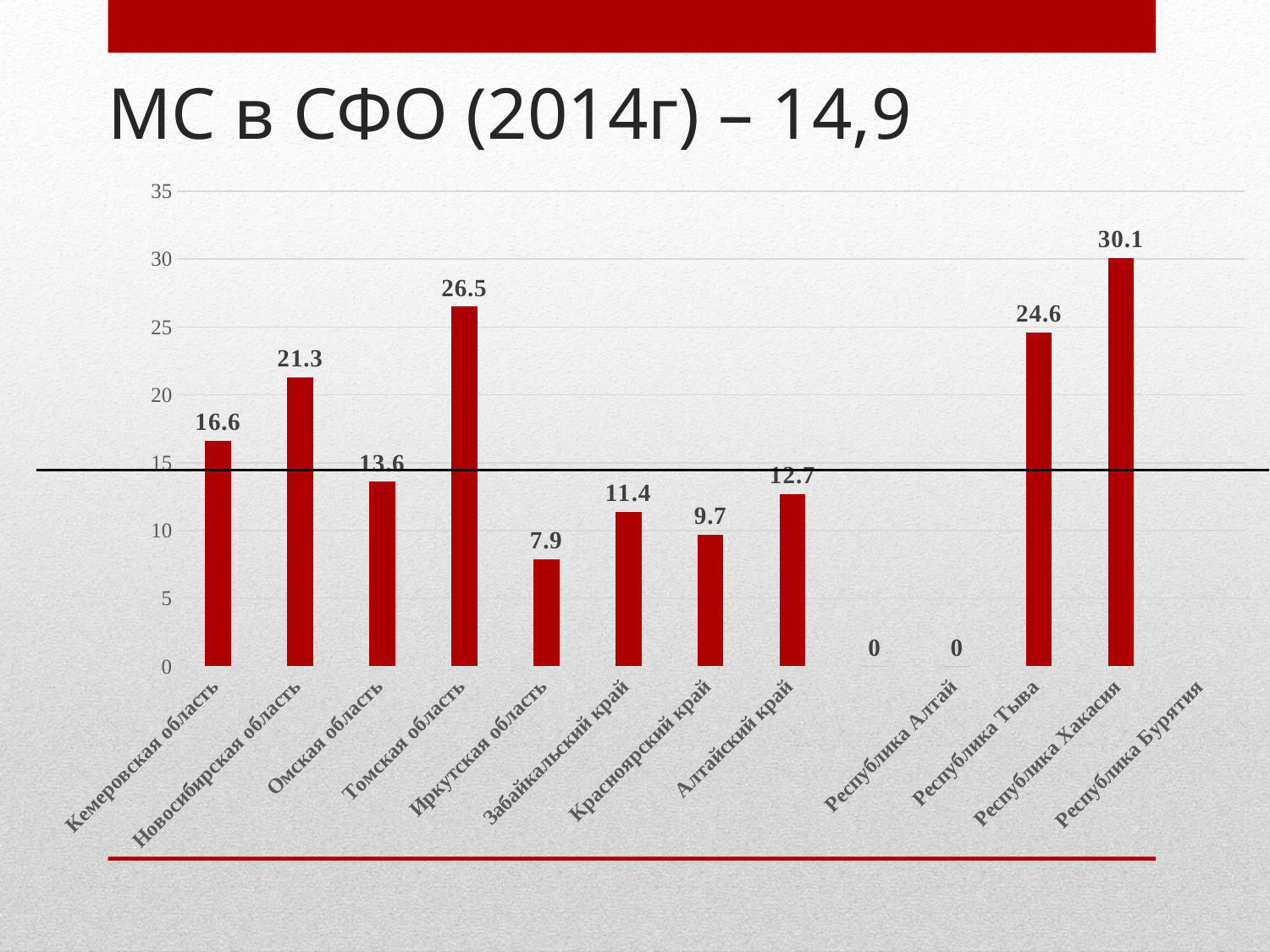
What is the difference between the values for Республика Хакасия and Томская область? 3.6 What is the difference between the values for Кемеровская область and Омская область? 3 Which category has the highest value? Республика Хакасия What is the value for Республика Тыва? 24.6 What is the value for Иркутская область? 7.9 What is the title of the slide? МС в СФО (2014г) – 14,9 What kind of chart is shown on the slide? bar chart Is the value for Алтайский край greater or less than 15? less What is the value for Забайкальский край? 11.4 Which is larger, the value for Красноярский край or Забайкальский край? Забайкальский край Which is larger, the value for Новосибирская область or Омская область? Новосибирская область What is the value for Томская область? 26.5